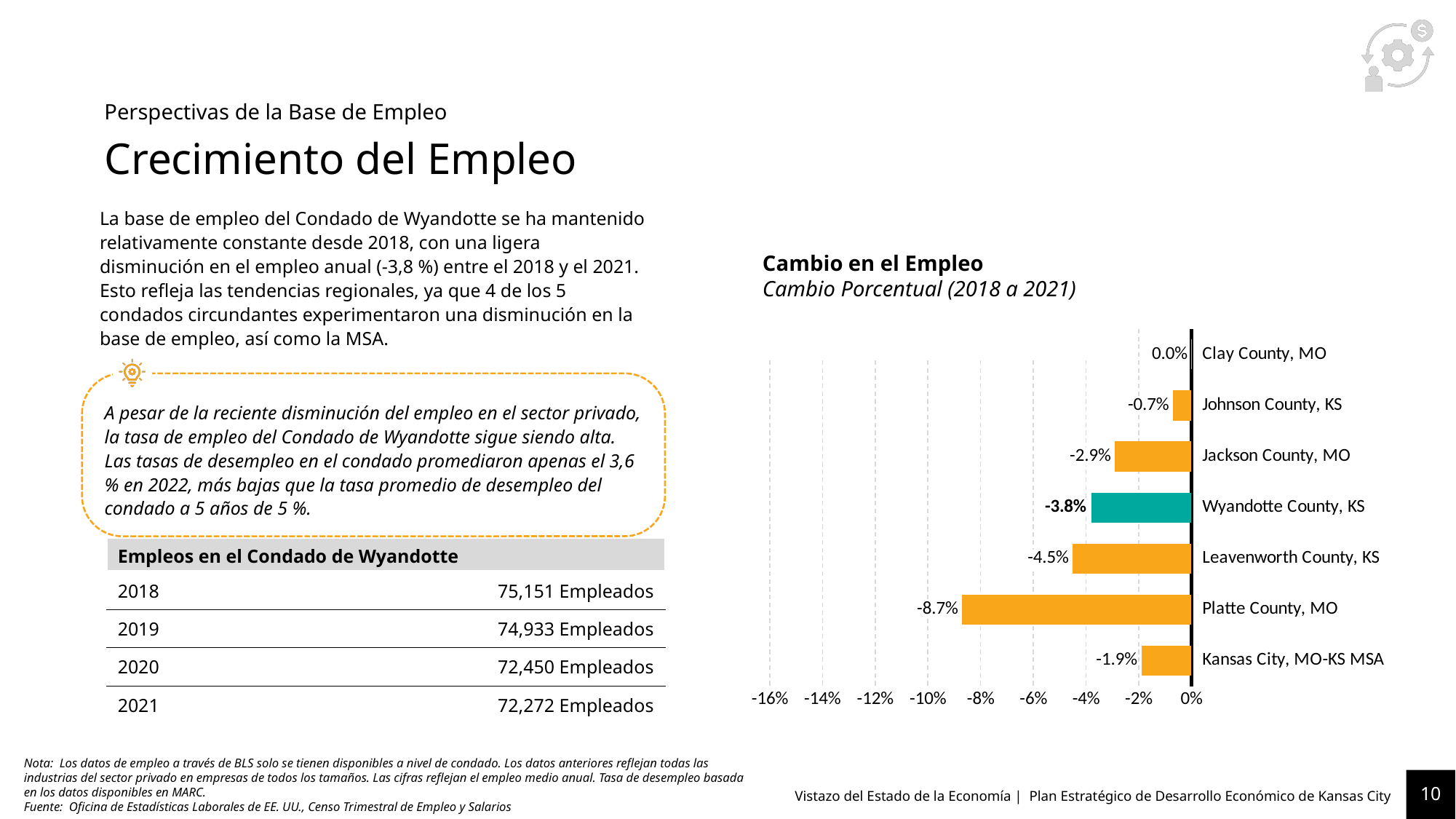
Which bar in the chart is coloured differently (teal) from the others? Wyandotte County, KS Which had a larger decline in employment, Leavenworth County, KS or Johnson County, KS? Leavenworth County, KS Which county shows the largest decline in employment? Platte County, MO What is the percentage change in employment for Wyandotte County, KS? -3.8% Which county has the highest (least negative) percentage change in employment? Clay County, MO What is the percentage change in employment for Jackson County, MO? -2.9% What type of chart is used to show the change in employment? Bar chart What is the percentage change in employment for the Kansas City, MO-KS MSA? -1.9% What is the percentage change in employment for Platte County, MO? -8.7% What is the difference in percentage points between the employment change for Platte County, MO and Wyandotte County, KS? 4.9 percentage points What is the subtitle of the chart? Cambio Porcentual (2018 a 2021) How many counties or areas are shown in the chart? 7